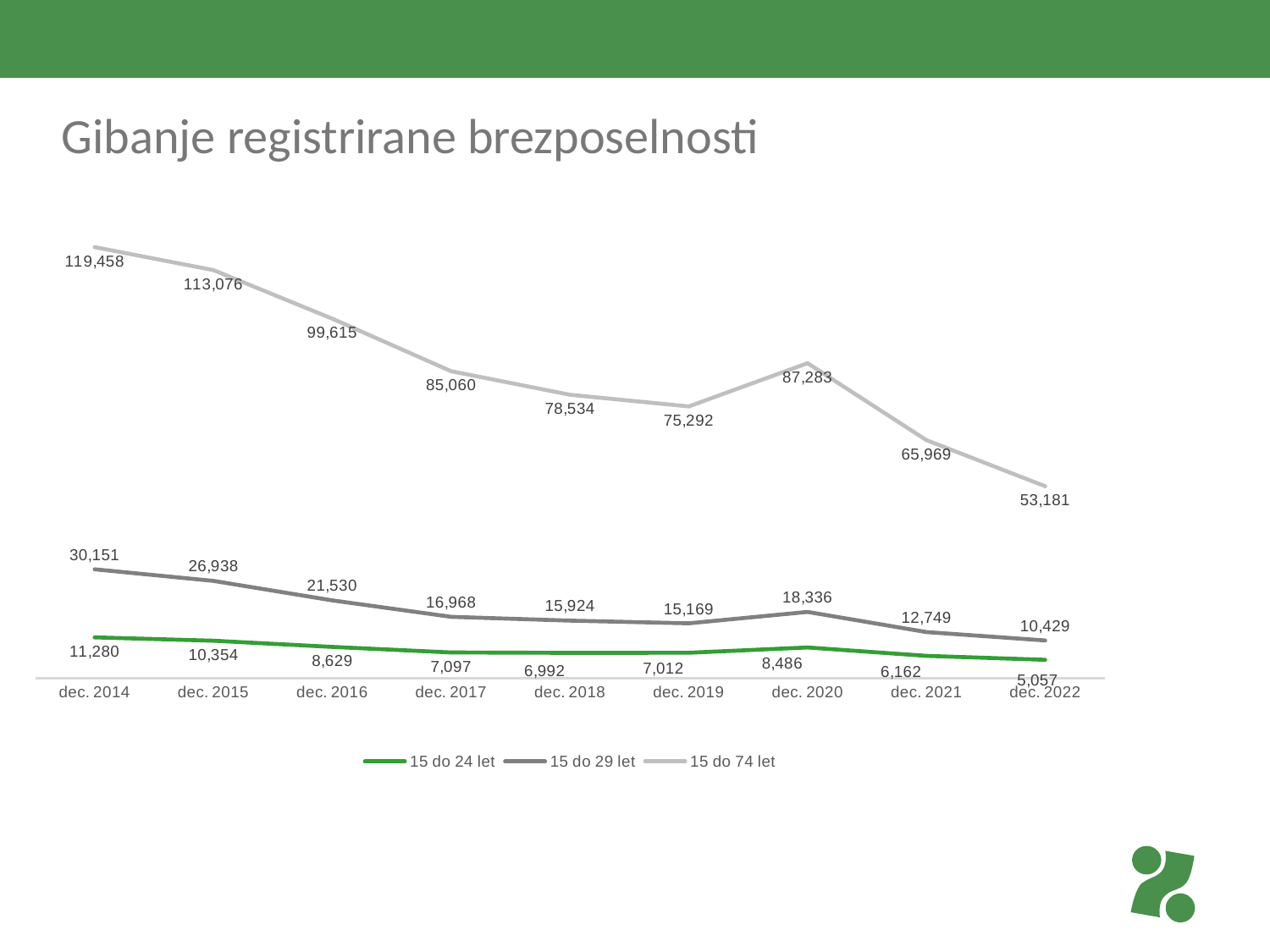
How many time points are plotted on the x axis? 9 Which is larger for the 15 do 24 let series: the value in dec. 2018 or in dec. 2019? dec. 2019 What is the difference between the 15 do 74 let values in dec. 2014 and dec. 2022? 66,277 What is the value for the 15 do 29 let series in dec. 2017? 16,968 What is the value for the 15 do 24 let series in dec. 2022? 5,057 What kind of chart is shown on the slide? Line chart By how much did the 15 do 29 let series increase from dec. 2019 to dec. 2020? 3,167 In which period does the 15 do 24 let series reach its lowest value? dec. 2022 What is the value for the 15 do 74 let series in dec. 2020? 87,283 What is the title of the chart on the slide? Gibanje registrirane brezposelnosti In which period does the 15 do 74 let series reach its highest value? dec. 2014 How many series does the legend list? 3